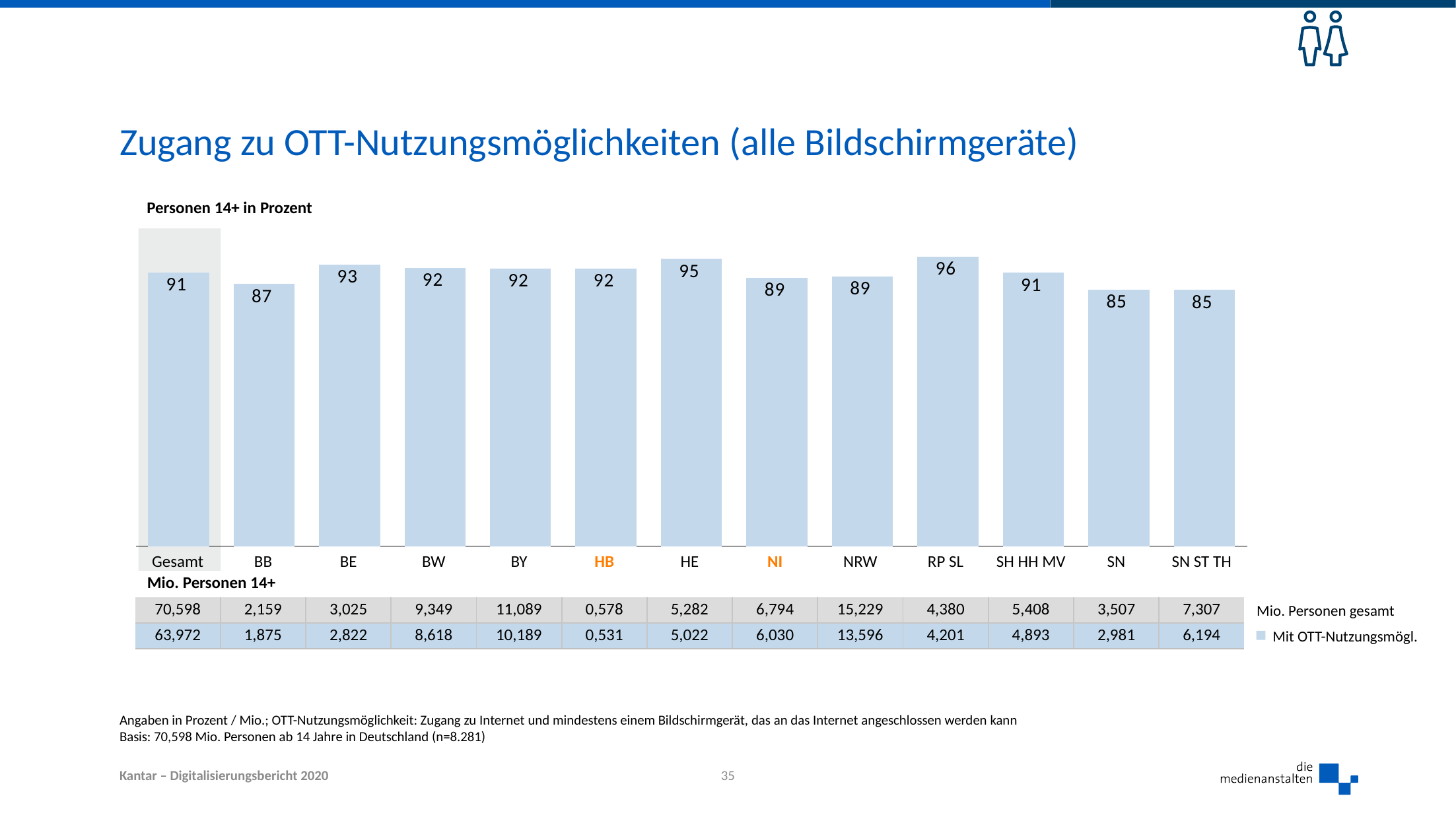
What is the title of the slide's chart? Zugang zu OTT-Nutzungsmöglichkeiten (alle Bildschirmgeräte) What is the value for HE in the chart? 95 Which category has the highest value in the chart? RP SL How many categories are shown on the x axis of the chart? 13 Which has a larger value, BB or BW? BW What kind of chart is shown on the slide? bar chart According to the table below the chart, how many Mio. Personen gesamt are listed for NRW? 15,229 What is the value for BB in the chart? 87 What is the difference between the values for RP SL and SN? 11 Which has a larger value, HE or NRW? HE What is the value for Gesamt in the chart? 91 What is the difference between the values for BE and NI? 4